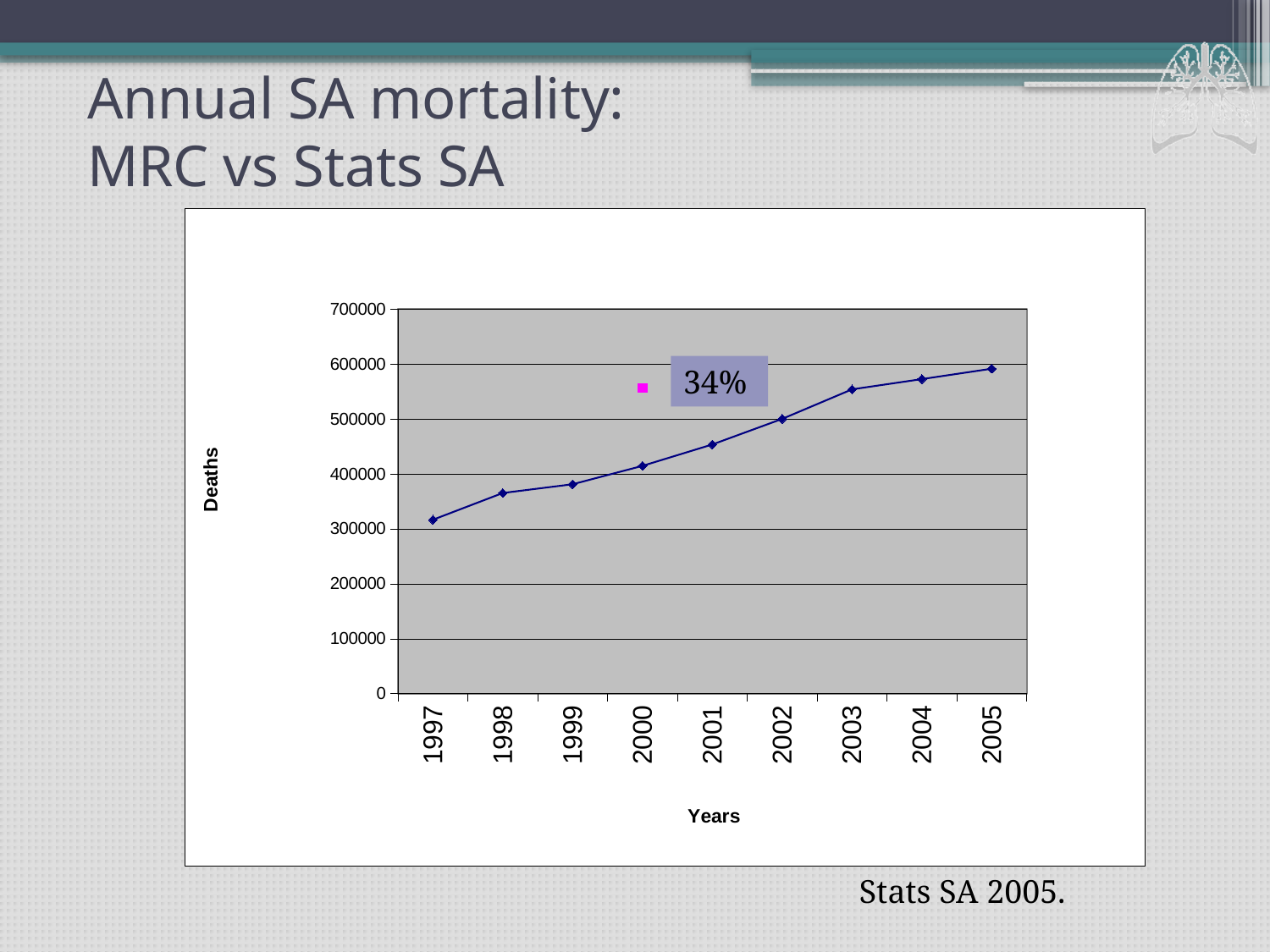
What kind of chart is shown on the slide? line chart What text appears in the legend box of the chart? 34% Which year has the lowest number of deaths? 1997 How many years are plotted along the x axis? 9 Which year has the highest number of deaths? 2005 Is the value for 1999 greater or less than 400000? less Which year has more deaths, 2001 or 2004? 2004 Is the value for 2005 greater or less than 500000? greater Is the value for 2003 greater or less than 500000? greater Do the number of deaths rise or fall from 1997 to 2005? rise What is the label on the y axis? Deaths